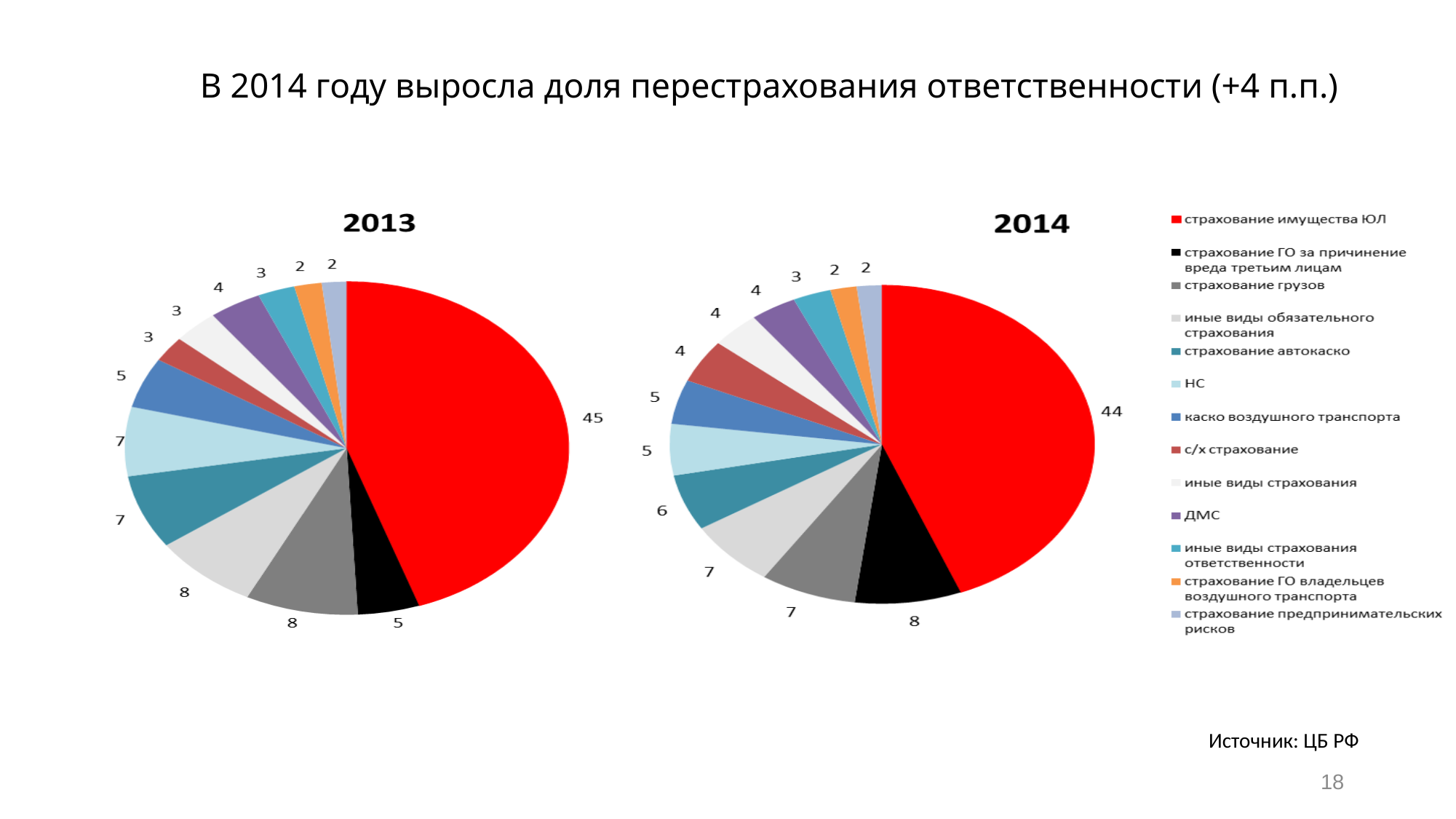
In the 2014 pie chart, what is the value for страхование имущества ЮЛ? 44 What colour is the slice for страхование имущества ЮЛ in both pie charts? Red How many categories does the legend list? 13 In the 2014 pie chart, which is larger: страхование грузов or страхование автокаско? страхование грузов In the 2013 pie chart, what is the value for страхование автокаско? 7 In the 2013 pie chart, what is the value for страхование ГО за причинение вреда третьим лицам? 5 What is the difference between the value for страхование ГО за причинение вреда третьим лицам in the 2014 chart and in the 2013 chart? 3 In the 2014 pie chart, what is the value for страхование ГО за причинение вреда третьим лицам? 8 In the 2013 pie chart, what is the value for страхование имущества ЮЛ? 45 What kind of charts are shown on the slide? Pie charts In the 2014 pie chart, what is the value for ДМС? 4 In the 2014 pie chart, which category has the largest slice? страхование имущества ЮЛ